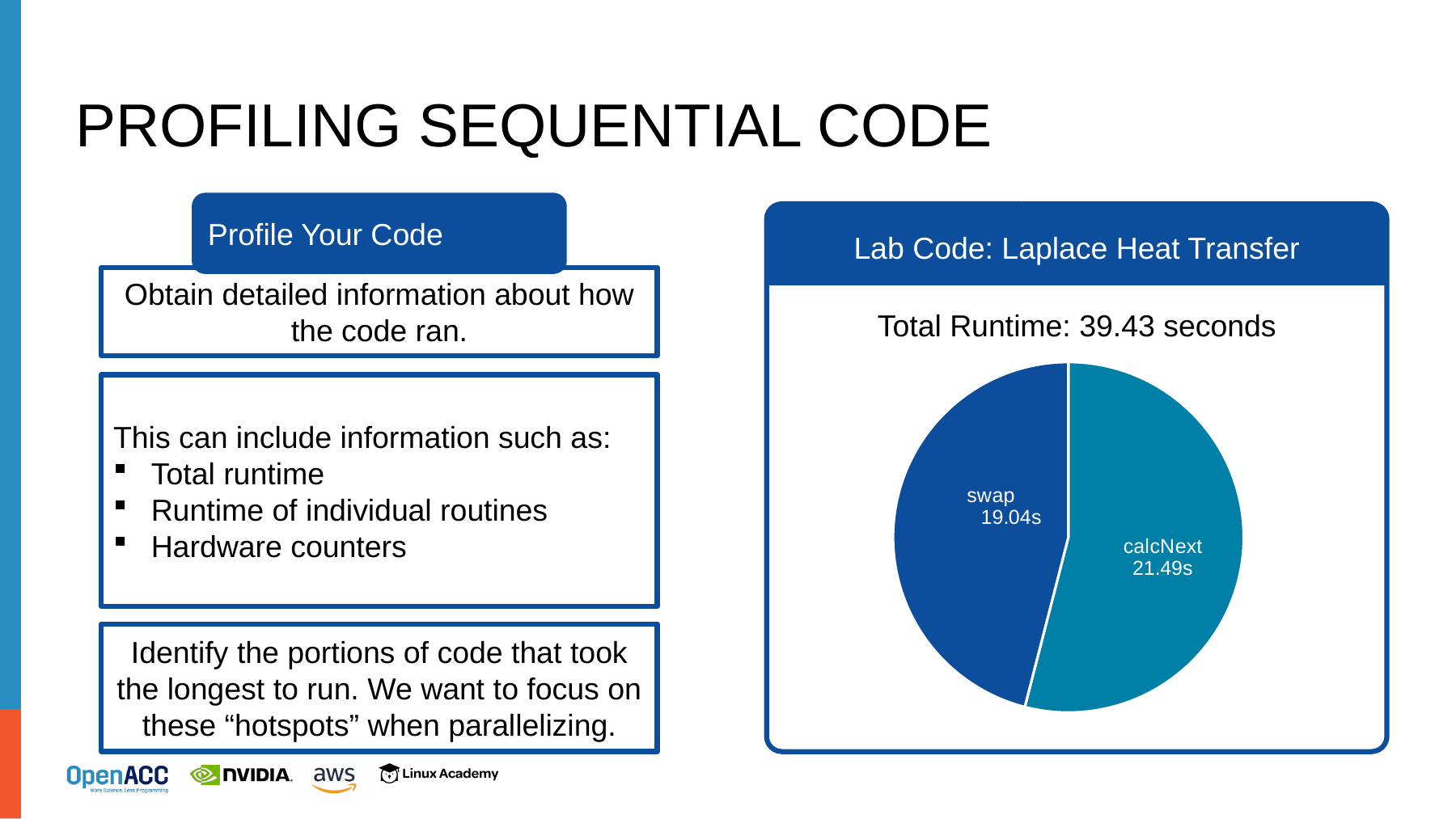
Which routine in the pie chart has the largest runtime? calcNext Which slice of the pie chart is coloured dark blue? swap What is the title of the box containing the pie chart? Lab Code: Laplace Heat Transfer How many slices does the pie chart have? 2 What is the total runtime stated above the pie chart? 39.43 seconds Which routine in the pie chart has the smallest runtime? swap Which has the larger runtime in the pie chart, swap or calcNext? calcNext What is the difference in runtime between calcNext and swap in the pie chart? 2.45s What is the runtime shown for swap in the pie chart? 19.04s What type of chart is shown on the slide? pie chart What is the runtime shown for calcNext in the pie chart? 21.49s